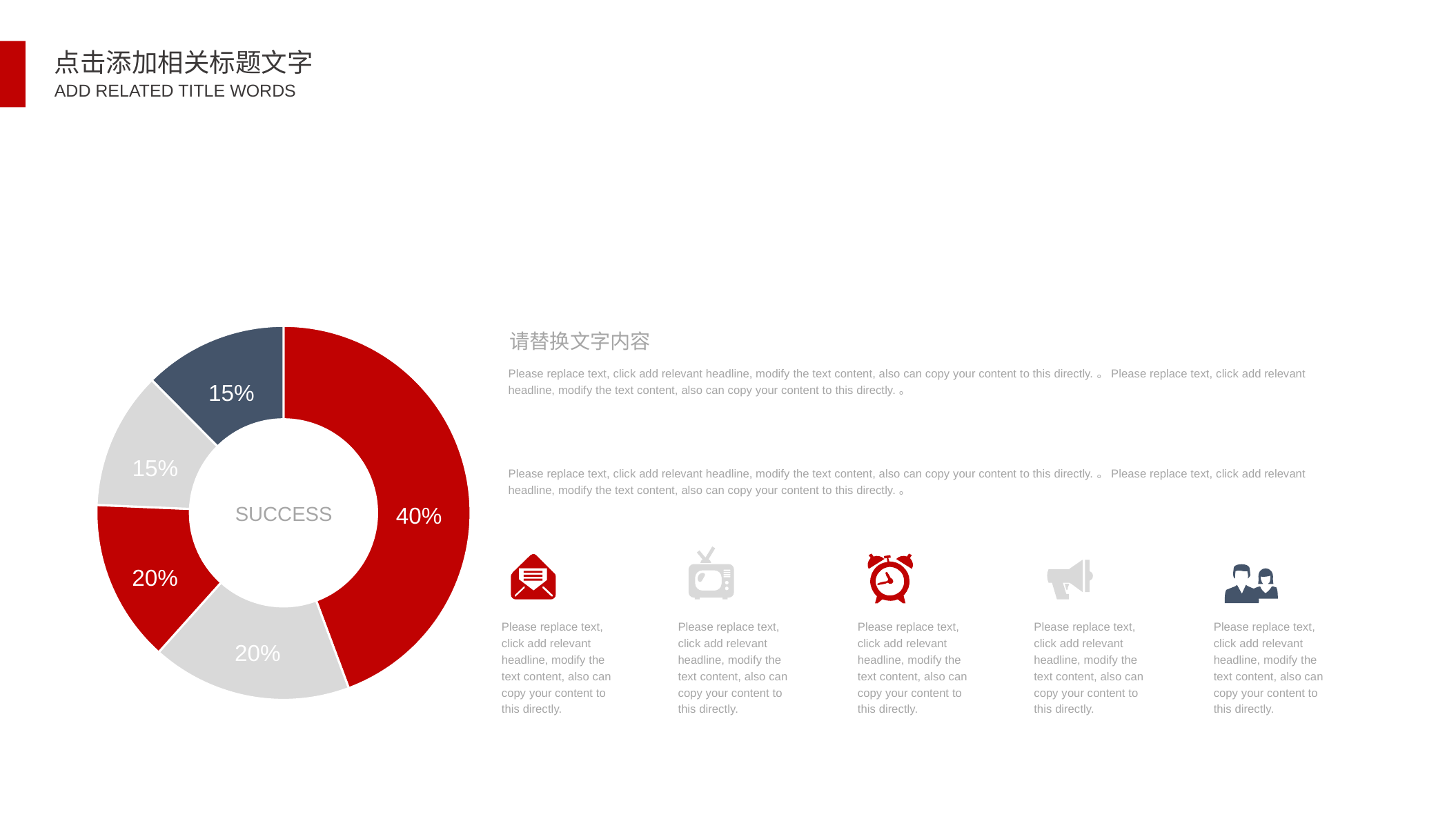
What is the value of the smallest slices in the donut chart? 15% How many slices does the donut chart have? 5 What is the value of the largest slice in the donut chart? 40% What value is labelled on the large red slice on the right side of the donut chart? 40% Which is larger: the red slice on the right or the red slice on the left of the donut chart? The red slice on the right What word is written in the centre of the donut chart? SUCCESS What kind of chart is shown on the slide? Donut chart How many slices in the donut chart are labelled 15%? 2 What value is labelled on the dark blue slice at the top of the donut chart? 15% What value is labelled on the light gray slice at the bottom of the donut chart? 20% What is the combined value of the two 20% slices in the donut chart? 40% What is the difference between the largest slice (40%) and the dark blue slice (15%)? 25%